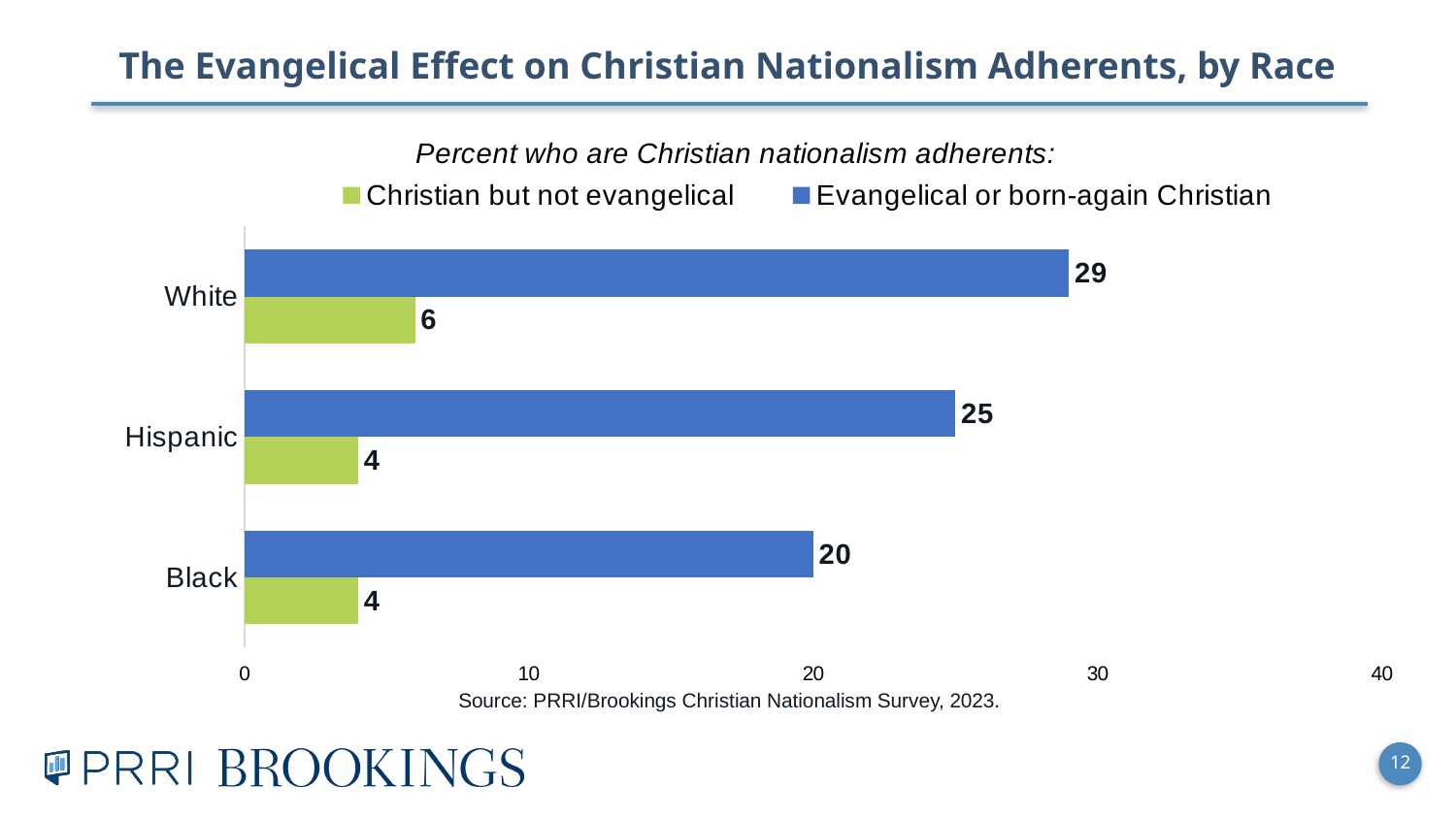
How many race categories are shown on the chart? 3 What is the value for Black in the Evangelical or born-again Christian series? 20 Is the Evangelical or born-again Christian value for Hispanic greater or less than 20? greater How many series does the legend list? 2 Which race category has the highest value in the Evangelical or born-again Christian series? White What is the difference between the Evangelical or born-again Christian values for Hispanic and Black? 5 What is the difference between the Evangelical or born-again Christian value and the Christian but not evangelical value for White? 23 What is the value for White in the Evangelical or born-again Christian series? 29 What is the value for Hispanic in the Christian but not evangelical series? 4 Which is larger: the Christian but not evangelical value for White or for Hispanic? White What kind of chart is shown on the slide? Bar chart Which race category has the lowest value in the Evangelical or born-again Christian series? Black